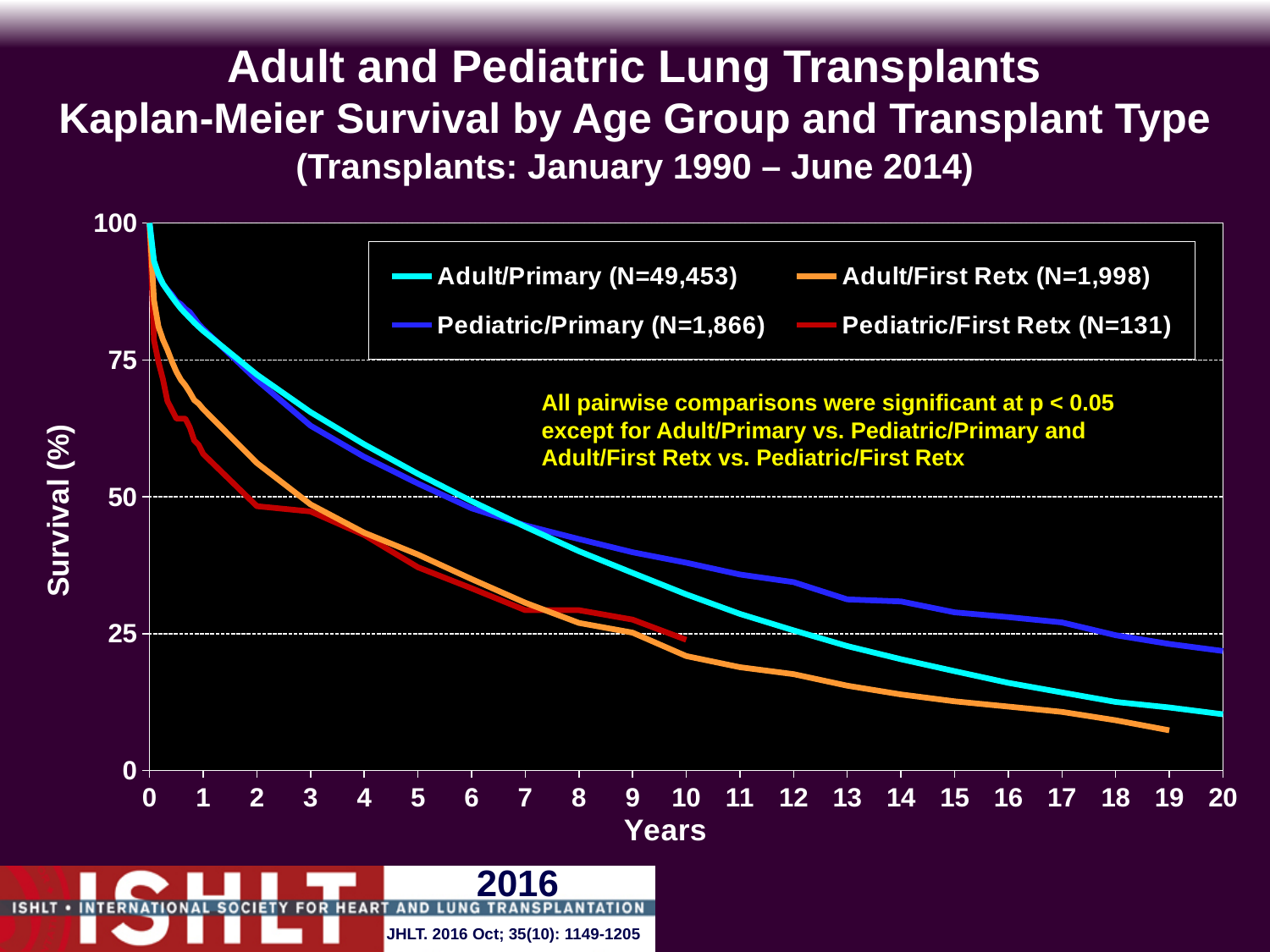
Is the survival value for Adult/Primary at year 10 greater or less than 25? greater Is the survival value for Pediatric/Primary at year 15 greater or less than 25? greater Do the survival curves rise or fall as the years increase? fall Which series has the highest survival at year 20? Pediatric/Primary What kind of chart is shown on the slide? line chart Which series has the largest N in the legend? Adult/Primary At year 15, which series has higher survival: Adult/Primary or Pediatric/Primary? Pediatric/Primary Is the survival value for Adult/First Retx at year 12 greater or less than 25? less What is the N shown in the legend for Adult/First Retx? 1,998 How many series does the legend list? 4 At year 5, which series has higher survival: Adult/Primary or Adult/First Retx? Adult/Primary